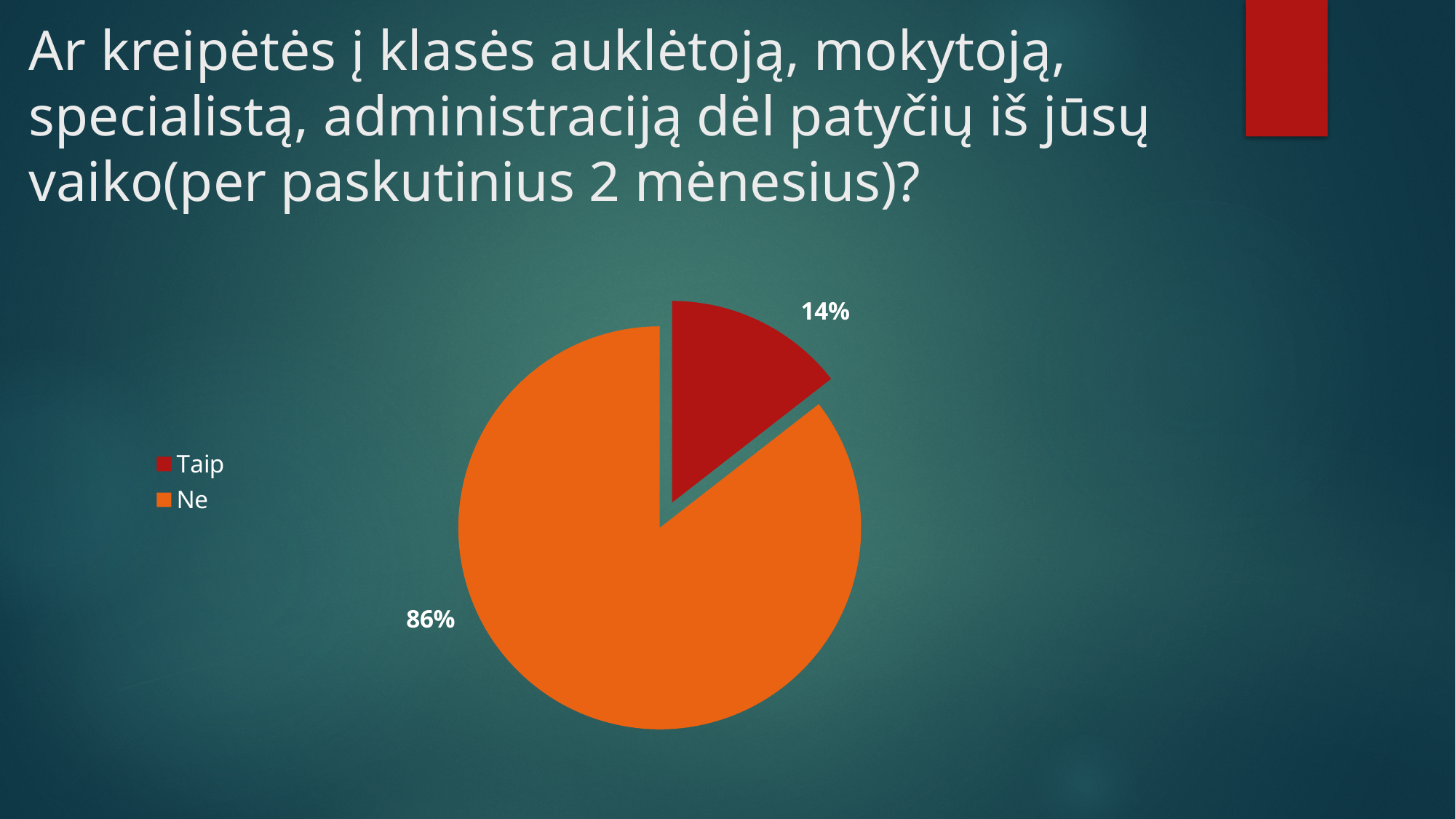
What kind of chart is shown on the slide? pie chart What percentage of the pie is labelled "Taip"? 14% What colour is the "Ne" slice of the pie? orange What share of the pie does the "Taip" slice represent? 14% What is the difference in percentage points between the "Ne" slice and the "Taip" slice? 72 Which slice is pulled out (exploded) from the pie? Taip Which is larger, the "Taip" slice or the "Ne" slice? Ne How many entries does the legend list? 2 How many slices does the pie chart have? 2 Which slice of the pie is the largest? Ne Which slice of the pie is the smallest? Taip What percentage of the pie is labelled "Ne"? 86%